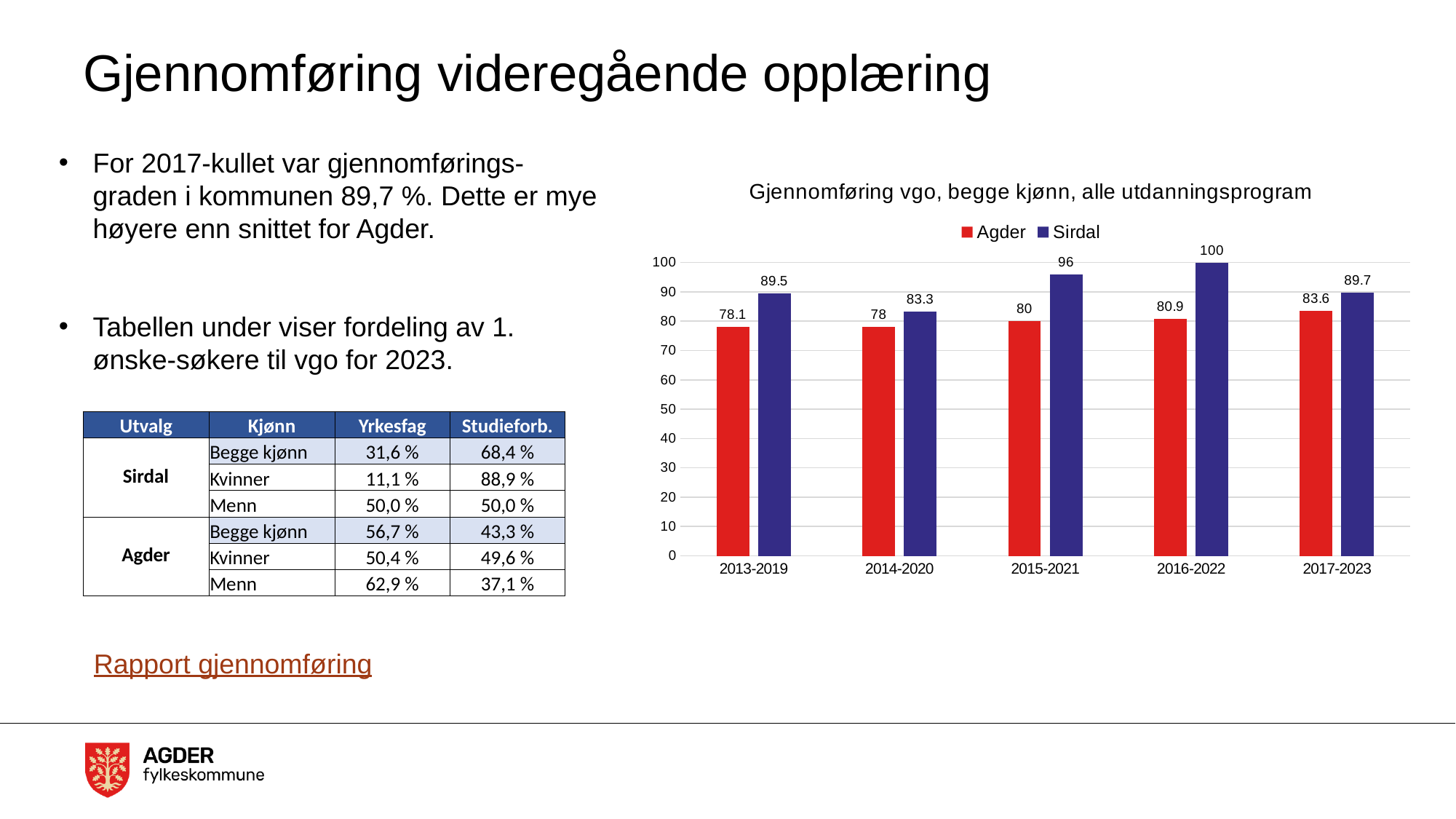
How many series does the legend list? 2 In which period is the Agder value lowest? 2014-2020 In which period is the Sirdal value highest? 2016-2022 What is the value for Sirdal in 2015-2021? 96 Which is larger in 2014-2020, Agder or Sirdal? Sirdal How many periods are shown on the x axis? 5 What kind of chart is shown? bar chart What is the value for Agder in 2013-2019? 78.1 What is the difference between Sirdal and Agder in 2016-2022? 19.1 What is the value for Sirdal in 2017-2023? 89.7 What is the title of the chart? Gjennomføring vgo, begge kjønn, alle utdanningsprogram Is the value for Agder in 2017-2023 greater or less than 90? less